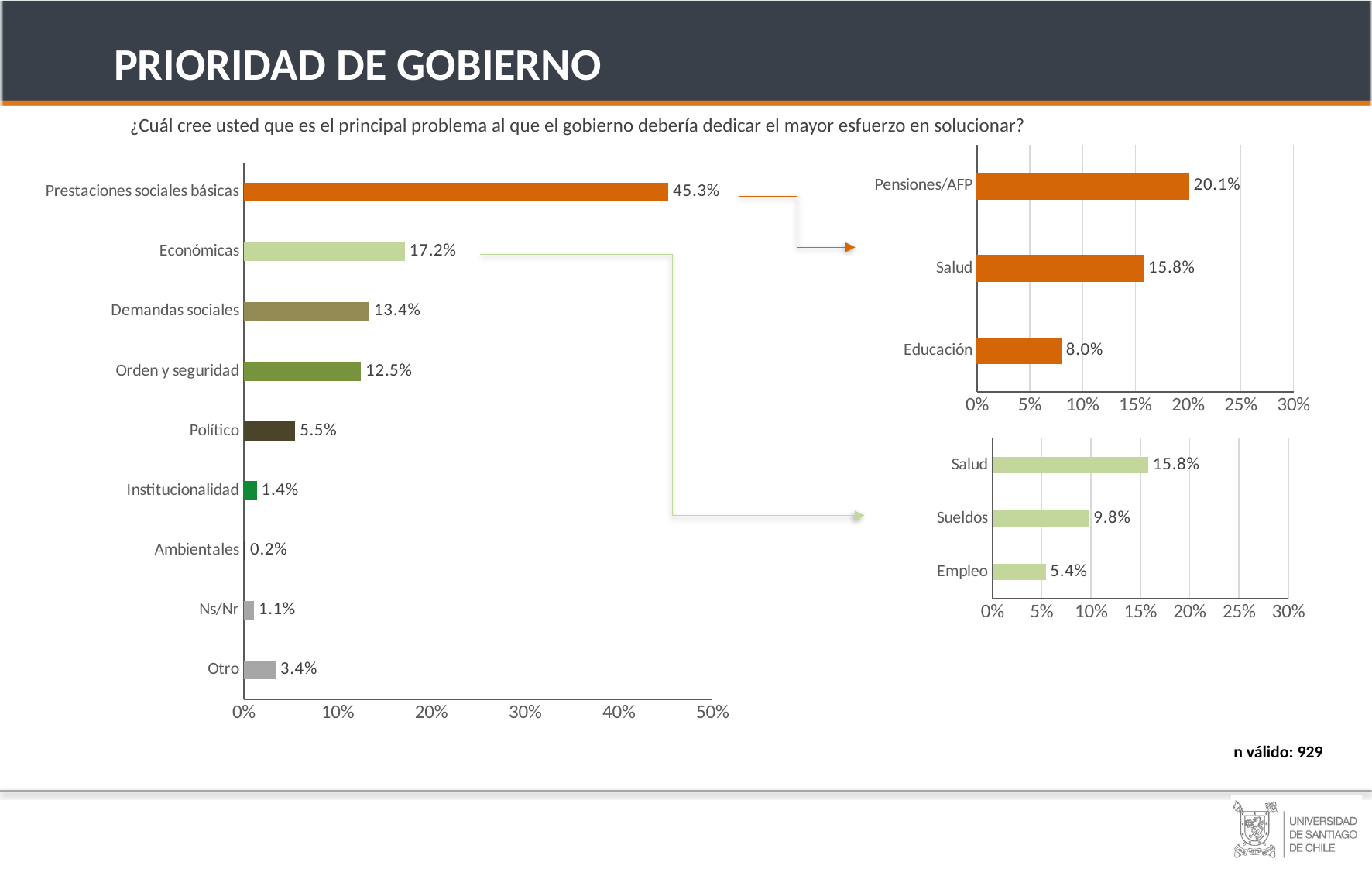
What kind of chart is the large chart on the left? Bar chart In the top-right chart, what is the value for Pensiones/AFP? 20.1% In the large chart on the left, what is the value for Orden y seguridad? 12.5% In the large chart on the left, what is the difference between Económicas and Demandas sociales? 3.8% In the large chart on the left, what is the value for Prestaciones sociales básicas? 45.3% In the large chart on the left, how many categories are shown? 9 In the bottom-right chart, what is the value for Sueldos? 9.8% In the top-right chart, what is the difference between Pensiones/AFP and Salud? 4.3% In the top-right chart, which category has the lowest value? Educación In the bottom-right chart, which category has the highest value? Salud In the large chart on the left, which is larger, Político or Otro? Político In the large chart on the left, which category has the lowest value? Ambientales